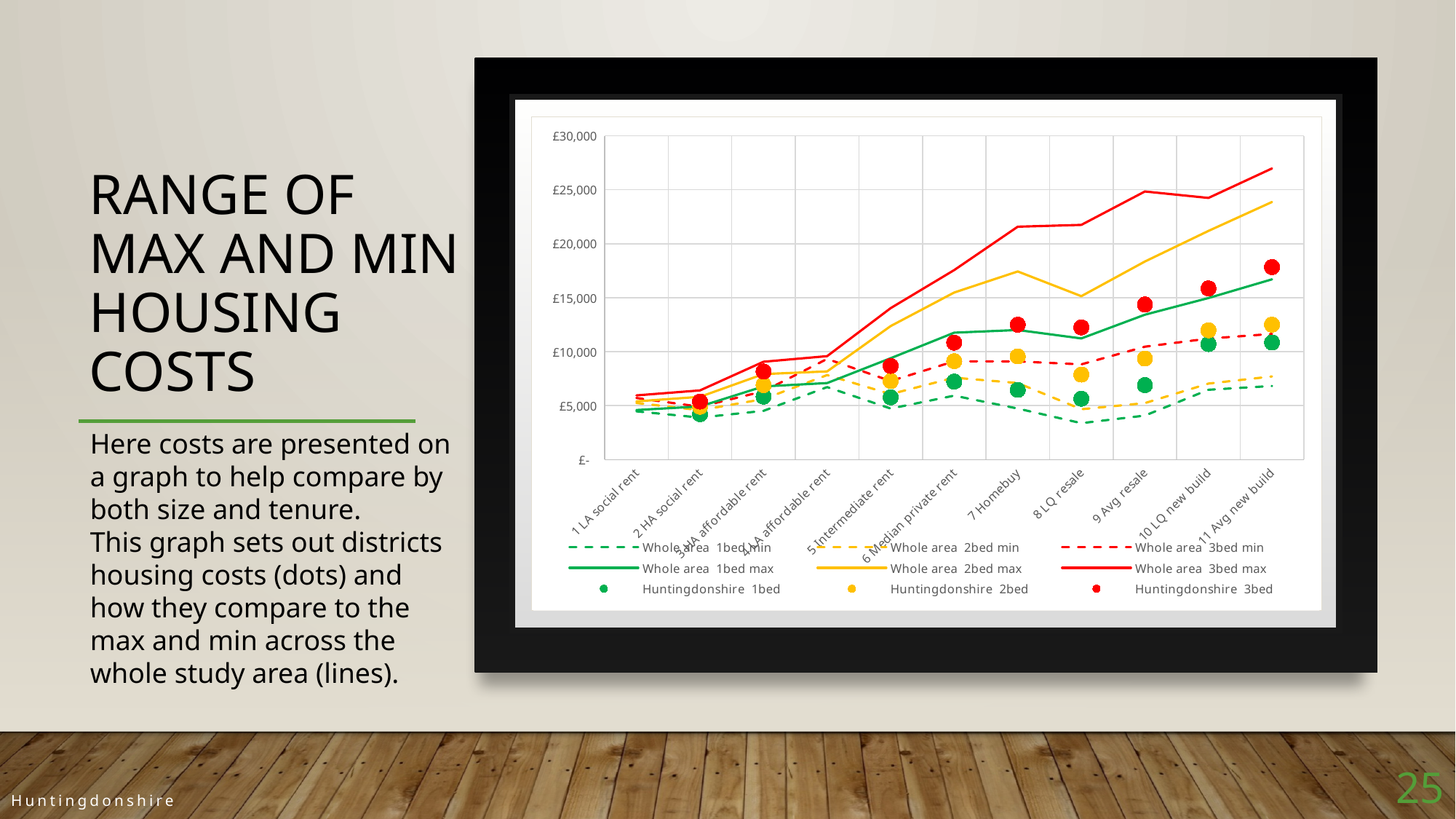
Does the Whole area 3bed max line generally rise or fall from 1 LA social rent to 11 Avg new build? Rise At 7 Homebuy, which is larger: Whole area 3bed max or Whole area 2bed max? Whole area 3bed max At which category is the Huntingdonshire 3bed dot highest? 11 Avg new build Is the Whole area 3bed max value at 7 Homebuy greater or less than £20,000? greater Is the value of the Whole area 3bed max line at 11 Avg new build greater or less than £25,000? greater Is the Huntingdonshire 1bed value at 2 HA social rent greater or less than £5,000? less What kind of chart is shown on the slide? Line chart At which category does the Whole area 3bed max line reach its highest value? 11 Avg new build How many categories are shown along the x axis of the chart? 11 How many series does the chart's legend list? 9